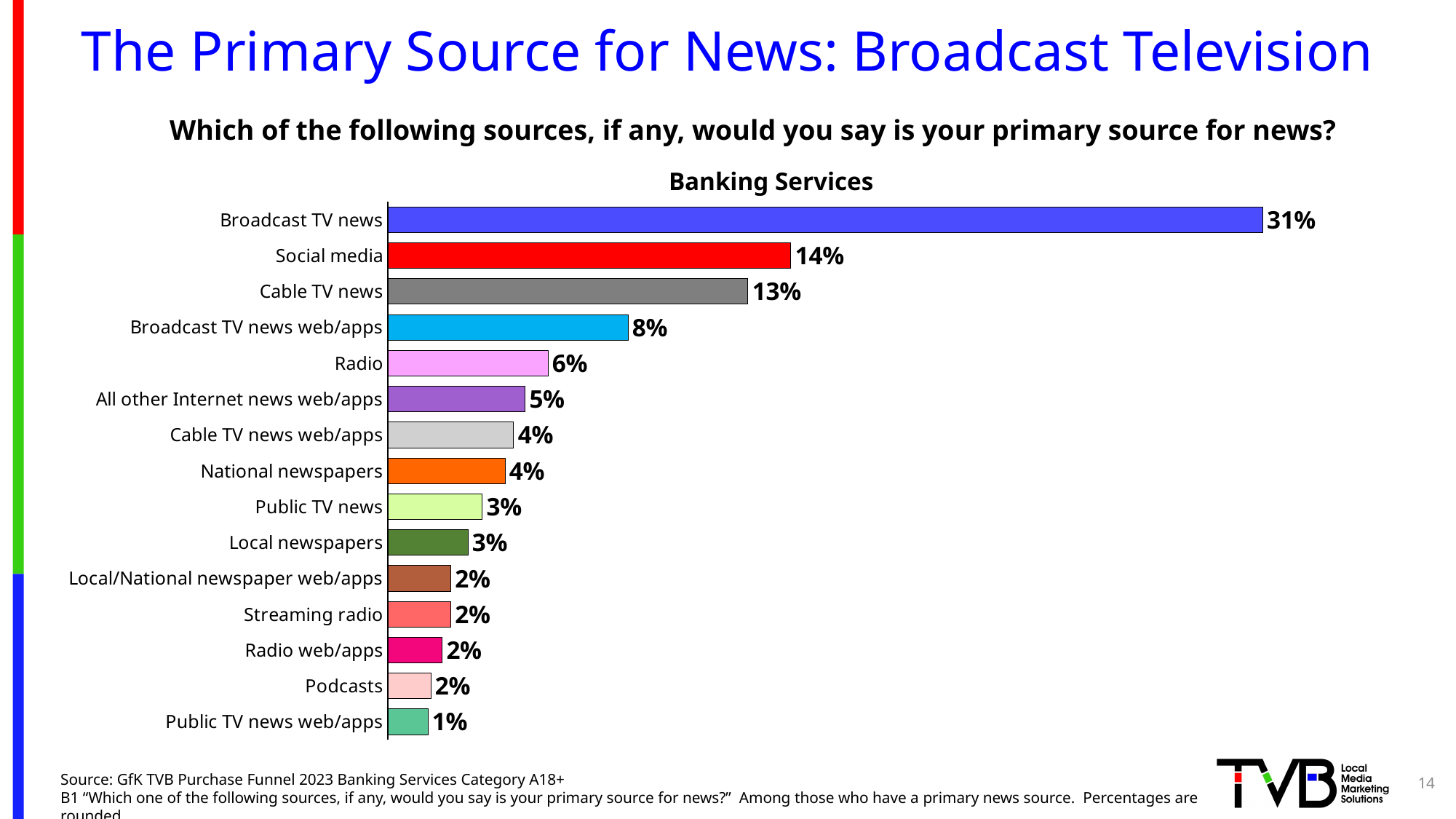
Which news source has the highest percentage in the chart? Broadcast TV news What is the difference in percentage points between Broadcast TV news and Social media? 17 Which has a larger value, Social media or Cable TV news? Social media What percentage is shown for Radio? 6% What type of chart is used on this slide? Bar chart What is the title printed directly above the chart? Banking Services What is the difference in percentage points between Cable TV news and Broadcast TV news web/apps? 5 How many news source categories are shown in the chart? 15 What is the value shown for Social media? 14% What percentage of respondents named Broadcast TV news as their primary source for news? 31% What is the value for Public TV news web/apps? 1% Which news source has the lowest percentage in the chart? Public TV news web/apps